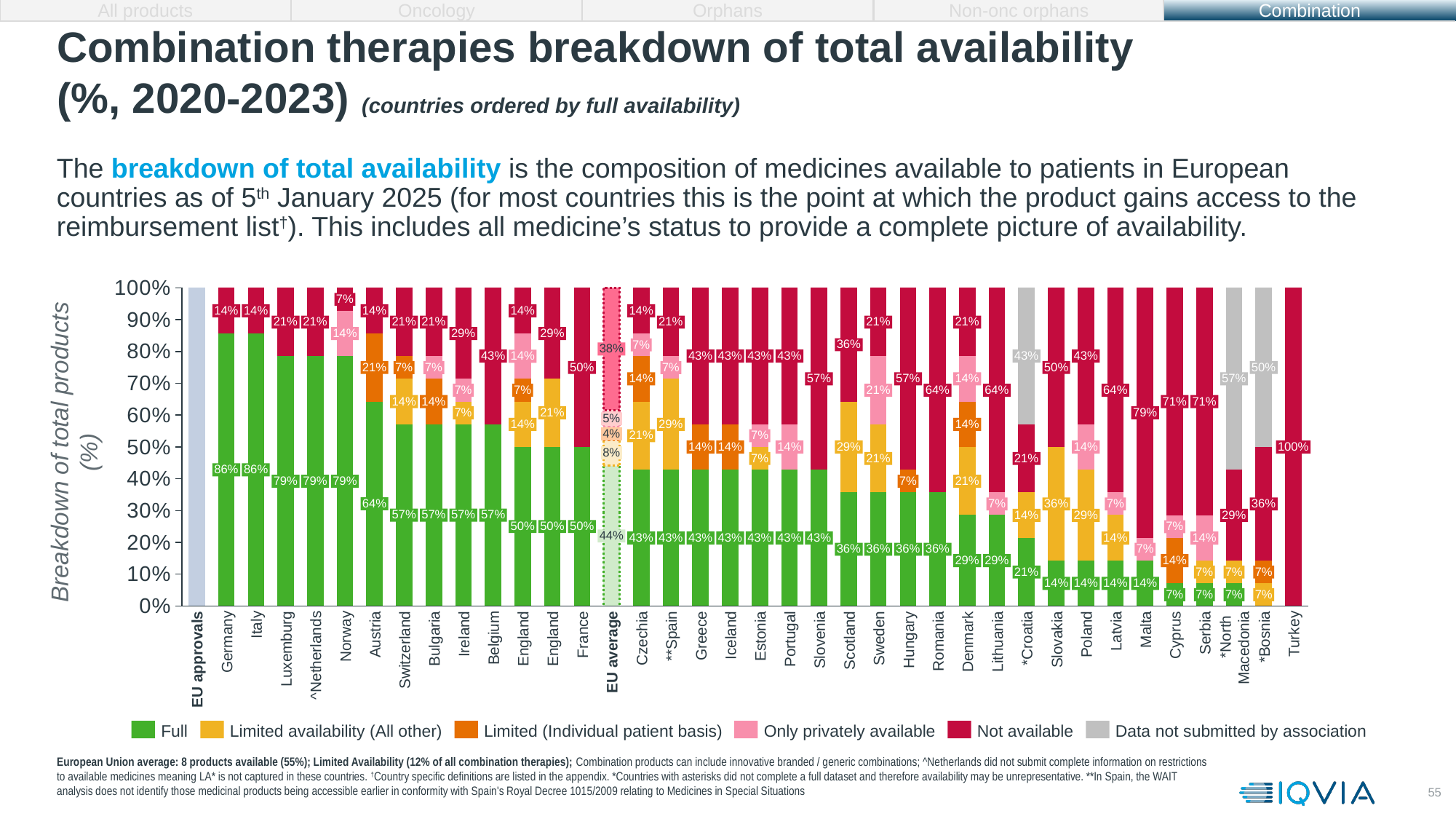
Which has a higher 'Full' availability share, Austria or Belgium? Austria What is the difference between Malta's 'Not available' share and its 'Full' share? 64% Which colour represents the 'Full' category in the legend? Green What is the 'Full' availability value for the EU average bar? 44% What share of products in *Croatia falls under 'Data not submitted by association'? 43% What is the 'Limited availability (All other)' value for Slovakia? 36% What percentage of combination therapies are fully available in Germany? 86% What kind of chart is shown on the slide? Stacked bar chart Which country has 100% of combination therapies in the 'Not available' category? Turkey How many series does the legend list? 6 What is the 'Not available' share for Turkey? 100% What is the difference between the 'Full' availability of Germany and France? 36%